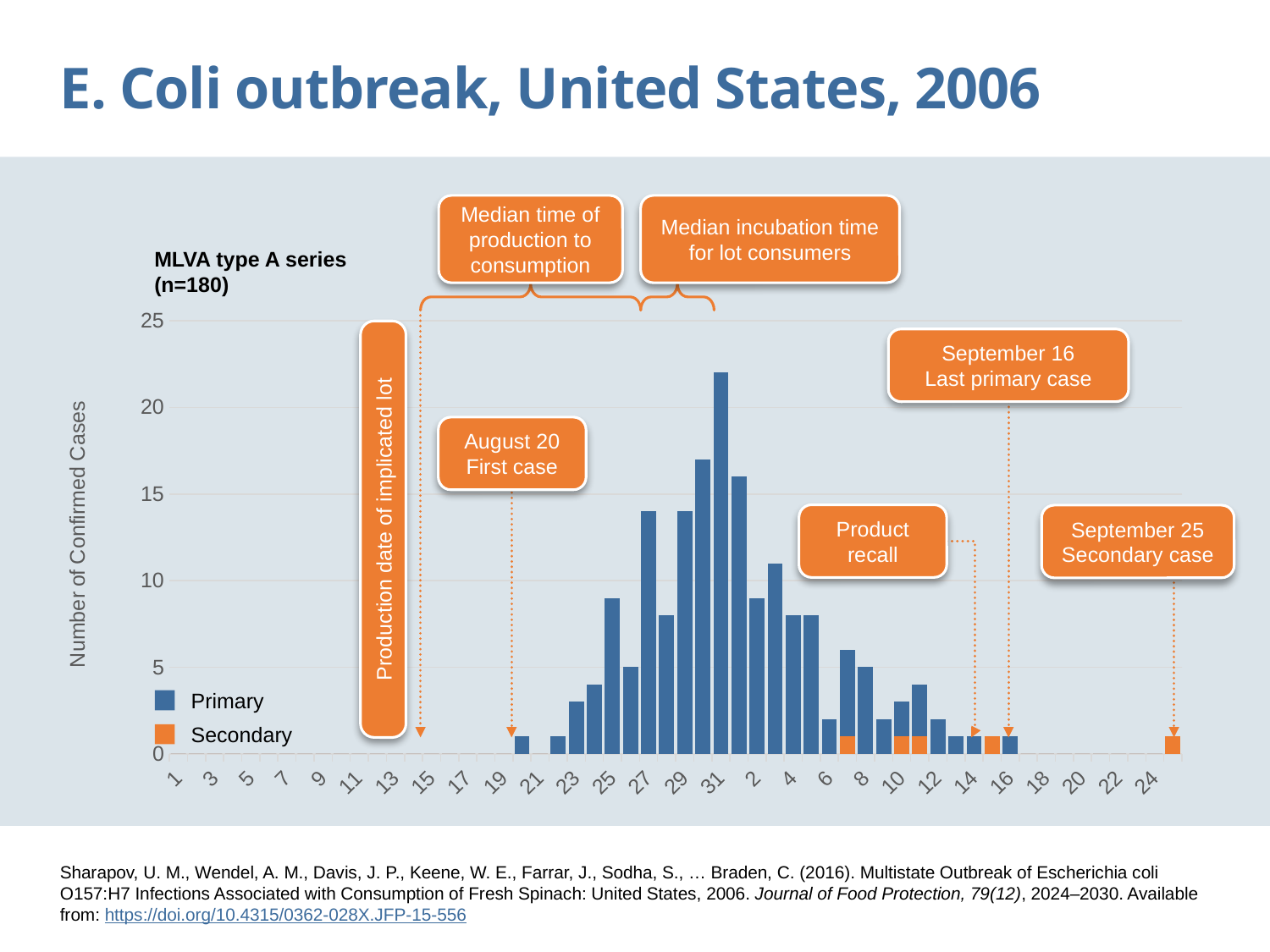
What are the two series named in the legend? Primary and Secondary Which colour represents Secondary cases in the chart? Orange Do the number of confirmed cases rise or fall between August 20 and August 31? Rise On which date does the tallest bar (most confirmed cases) occur? 31 (August 31) Is the number of confirmed cases on the 27th greater or less than 15? less What kind of chart is shown on the slide? Bar chart Is the number of confirmed cases on the 24th greater or less than 5? less According to the annotation, on what date was the first case? August 20 Is the number of confirmed cases on the 29th greater or less than 15? less How many series does the legend list? 2 Which day has more confirmed cases, the 31st or the 27th? 31st